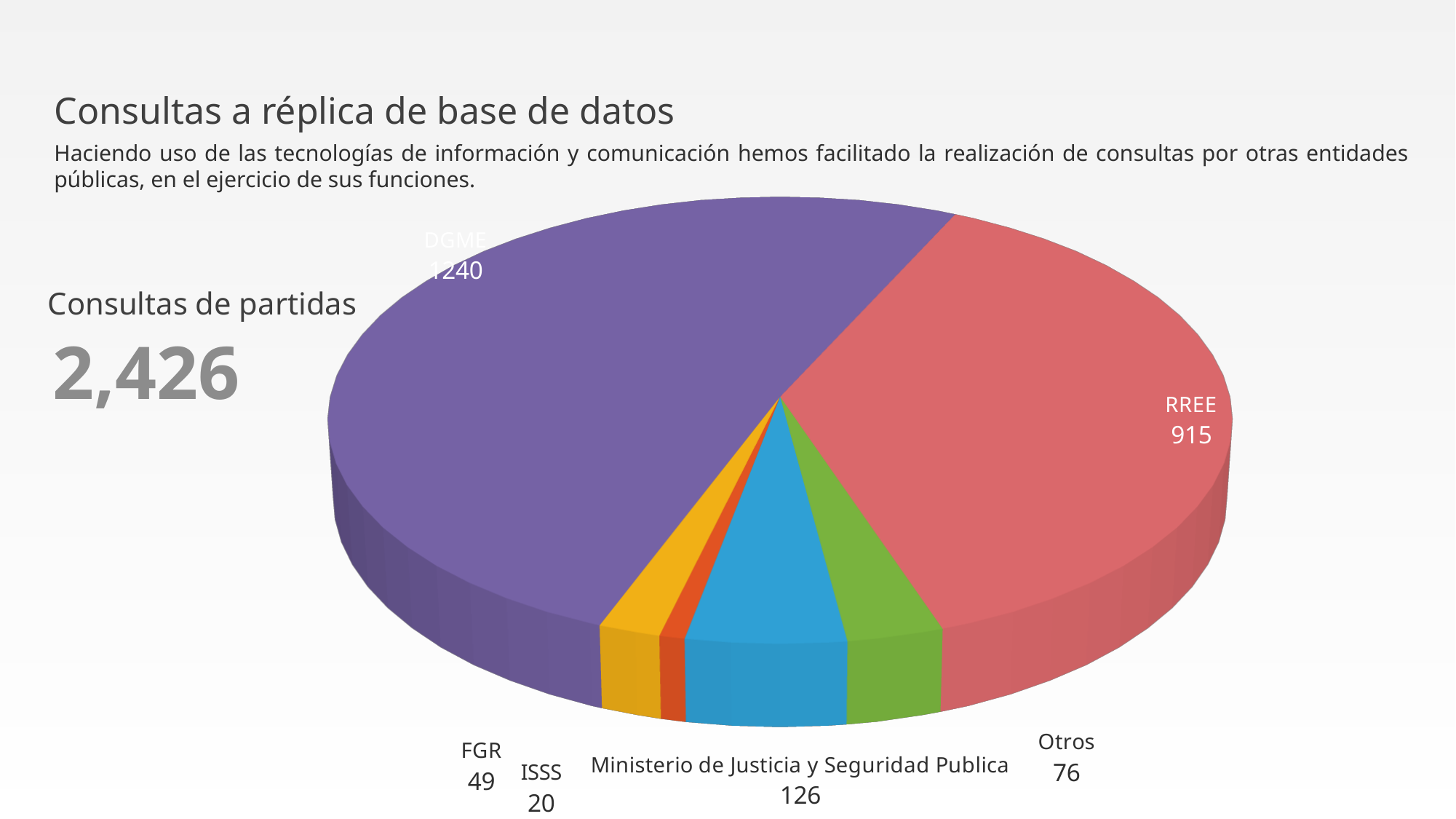
How many categories (slices) does the pie chart show? 6 What value is shown for FGR? 49 What total number of 'Consultas de partidas' is shown on the slide? 2,426 Which category has the smallest slice in the pie chart? ISSS What value is shown for ISSS? 20 What is the largest value labelled on the pie chart? 1240 Which is larger, the value for FGR or the value for Otros? Otros What is the difference between the values for RREE and Otros? 839 What value is shown for RREE in the pie chart? 915 What value is shown for Ministerio de Justicia y Seguridad Publica? 126 What value is shown for Otros? 76 What kind of chart is shown on the slide? Pie chart